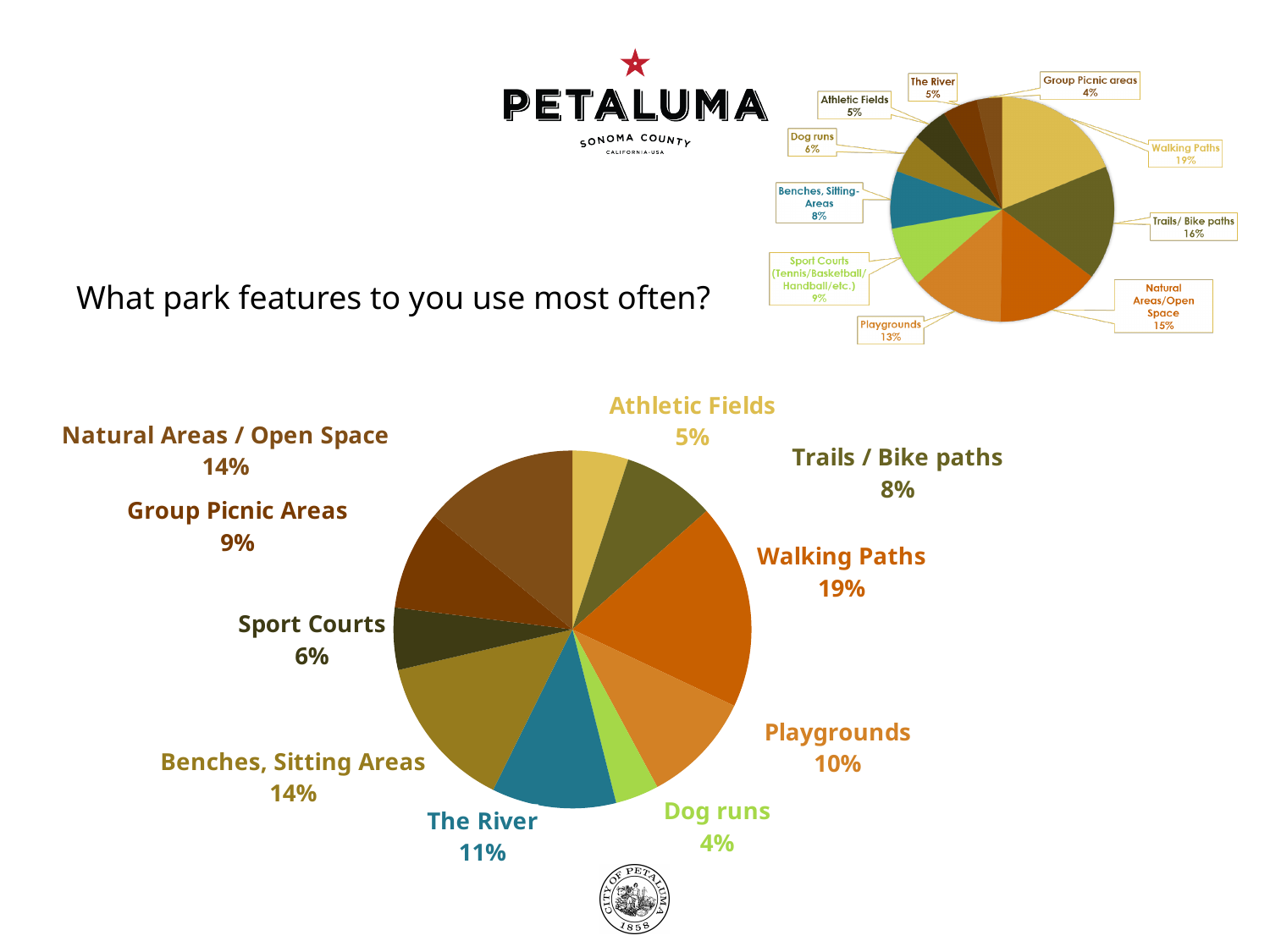
In the small pie chart at the top right of the slide, what is the difference between the Natural Areas/Open Space share and the Playgrounds share? 2% What type of chart is the large chart at the bottom of the slide? Pie chart How many categories are shown in the large pie chart at the bottom of the slide? 10 In the large pie chart at the bottom of the slide, which category has the largest share? Walking Paths In the large pie chart at the bottom of the slide, which is larger: Benches, Sitting Areas or Group Picnic Areas? Benches, Sitting Areas In the large pie chart at the bottom of the slide, what is the difference between the Walking Paths share and the Playgrounds share? 9% In the small pie chart at the top right of the slide, which category has the smallest share? Group Picnic areas In the large pie chart at the bottom of the slide, what percentage is shown for Walking Paths? 19% In the large pie chart at the bottom of the slide, which category has the smallest share? Dog runs What question is written on the slide next to the charts? What park features to you use most often? In the large pie chart at the bottom of the slide, what percentage is shown for The River? 11% In the small pie chart at the top right of the slide, what percentage is shown for Trails/ Bike paths? 16%